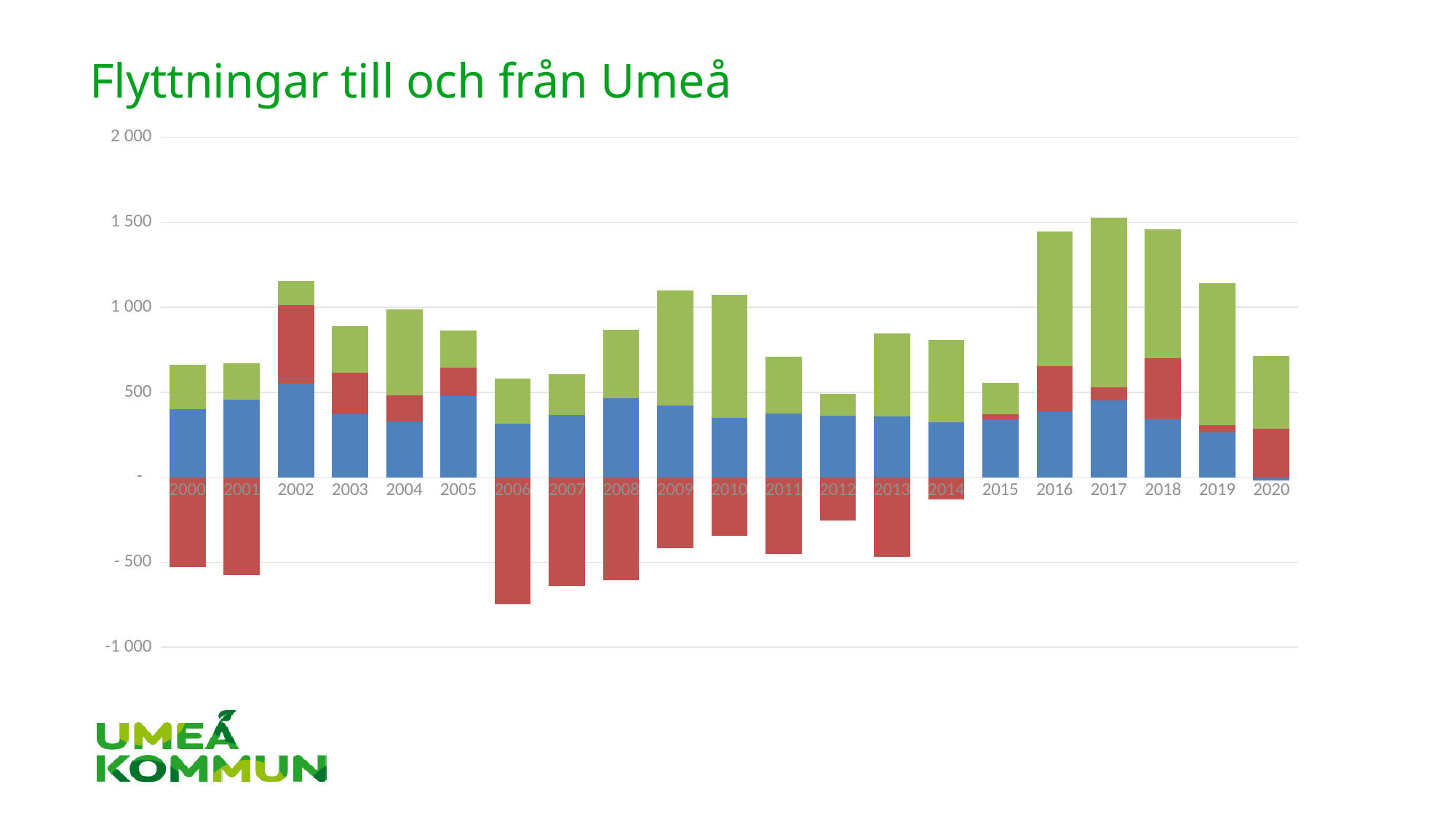
Which year has the red bar extending furthest below zero? 2006 Is the bottom of the red bar for 2010 greater or less than -500? greater Is the top of the stacked bar for 2016 greater or less than 1 500? less What kind of chart is shown on the slide? Stacked bar chart How many years are shown on the x axis of the chart? 21 What is the title of the chart on the slide? Flyttningar till och från Umeå Is the top of the stacked bar for 2019 greater or less than 1 000? greater Which year has the tallest stacked bar above zero? 2017 Which year has a taller stacked bar above zero, 2017 or 2015? 2017